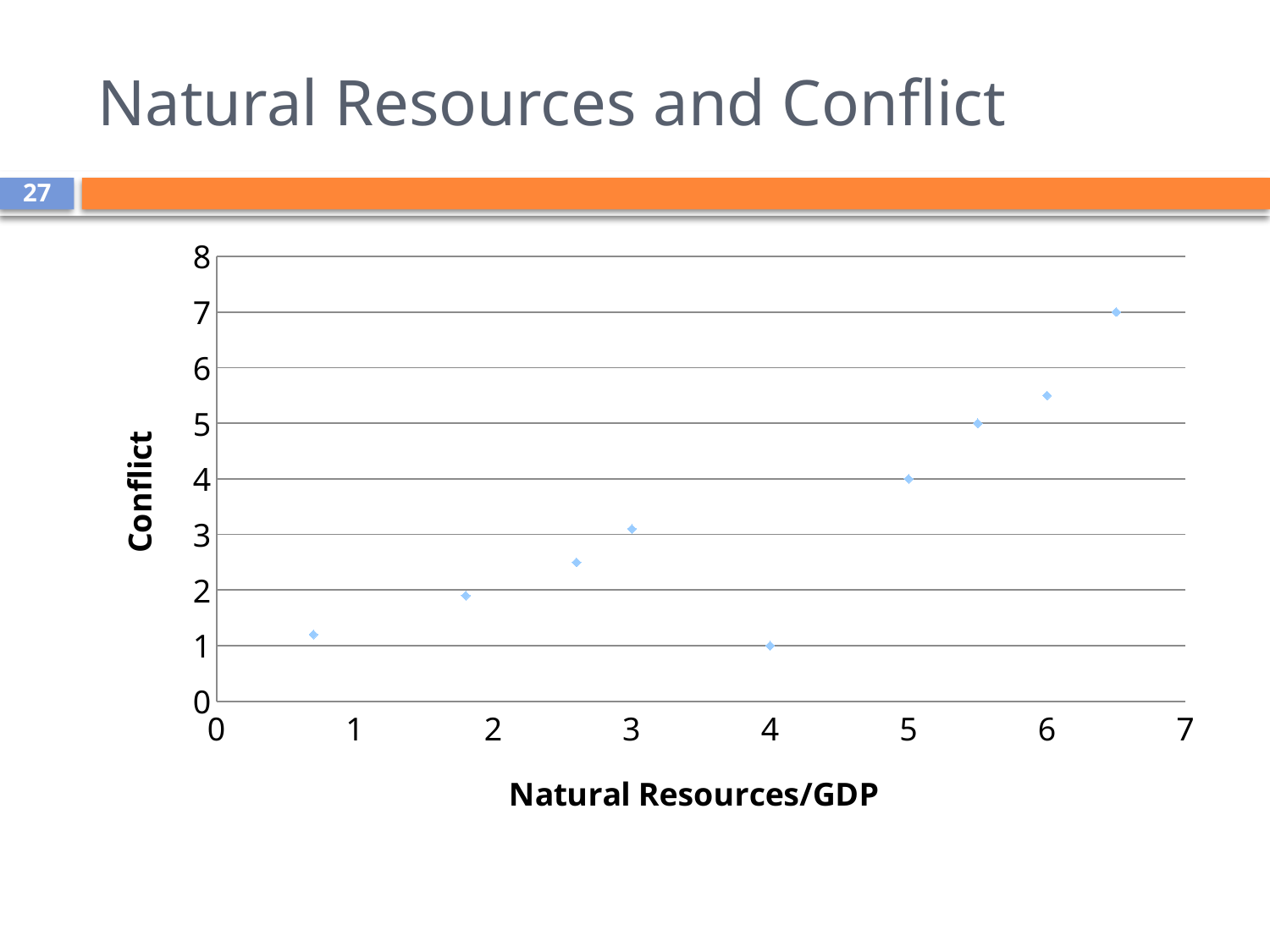
What is the highest value shown on the vertical axis? 8 What kind of chart is shown on the slide? scatter chart Is the Conflict value of the point at Natural Resources/GDP = 4 greater or less than 2? less What is the Conflict value of the point plotted at Natural Resources/GDP = 5? 4 What is the label of the vertical axis? Conflict What is the Conflict value of the point plotted at Natural Resources/GDP = 4? 1 What is the title of the slide's chart? Natural Resources and Conflict Which point has the higher Conflict value: the one at Natural Resources/GDP = 3 or the one at Natural Resources/GDP = 4? the one at 3 Is the Conflict value of the point at Natural Resources/GDP = 6 greater or less than 5? greater Do the Conflict values generally rise or fall as Natural Resources/GDP increases? rise What is the Conflict value of the highest point on the chart? 7 How many data points are plotted on the chart? 9